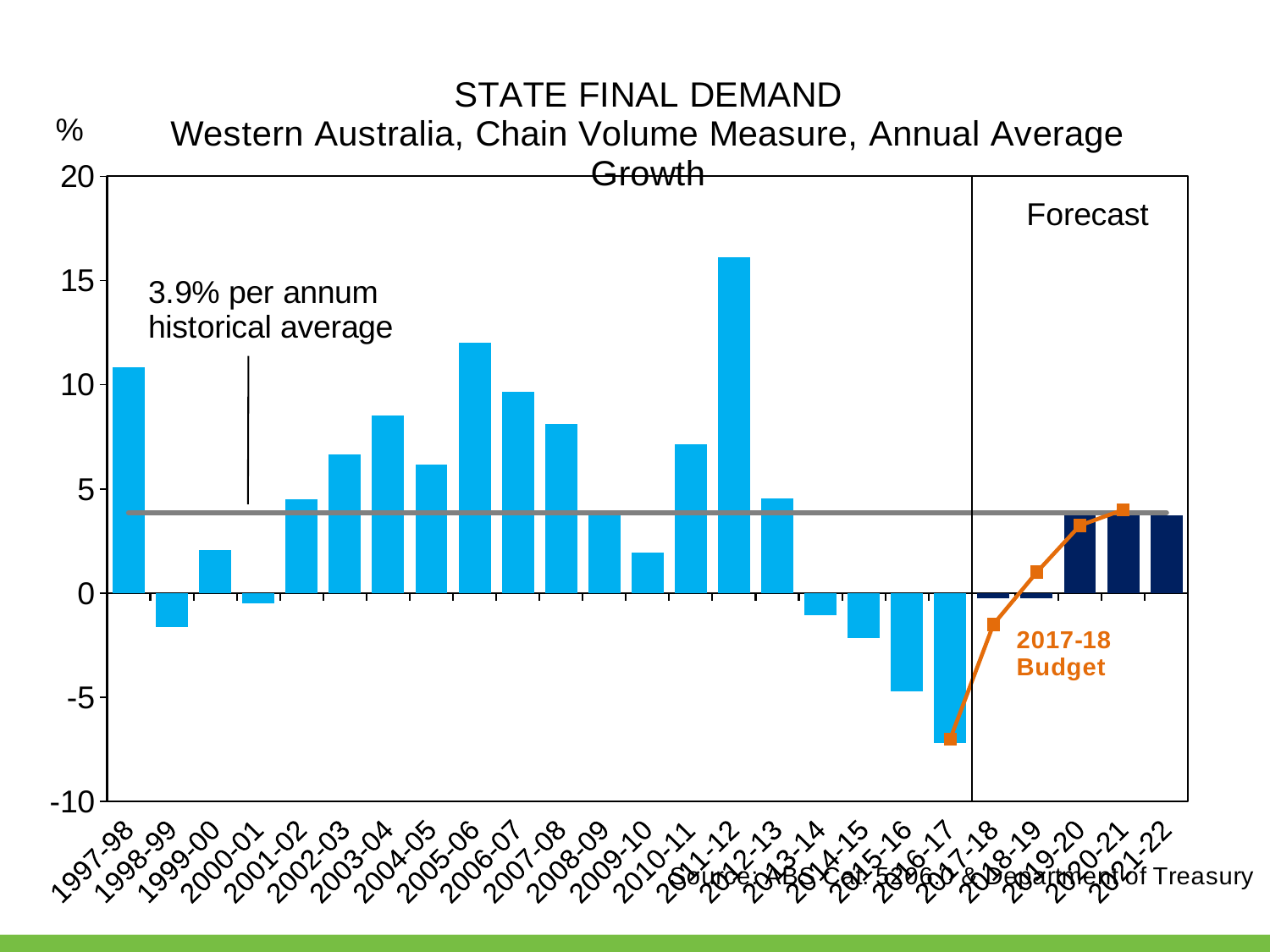
What label is shown in the shaded right-hand section of the chart covering 2017-18 onwards? Forecast What is the historical average annual growth rate shown on the chart? 3.9% per annum Do the values rise or fall from 2013-14 to 2016-17? fall Is the value for 2005-06 greater or less than 10? greater Is the value for 1997-98 greater or less than 10? greater How many years are shown on the x axis of the chart? 25 Is the value for 2016-17 greater or less than -5? less Which year has the lowest State Final Demand growth on the chart? 2016-17 Which year has the highest State Final Demand growth on the chart? 2011-12 What kind of chart is shown on the slide? combination bar and line chart Which year has the larger value, 2005-06 or 2006-07? 2005-06